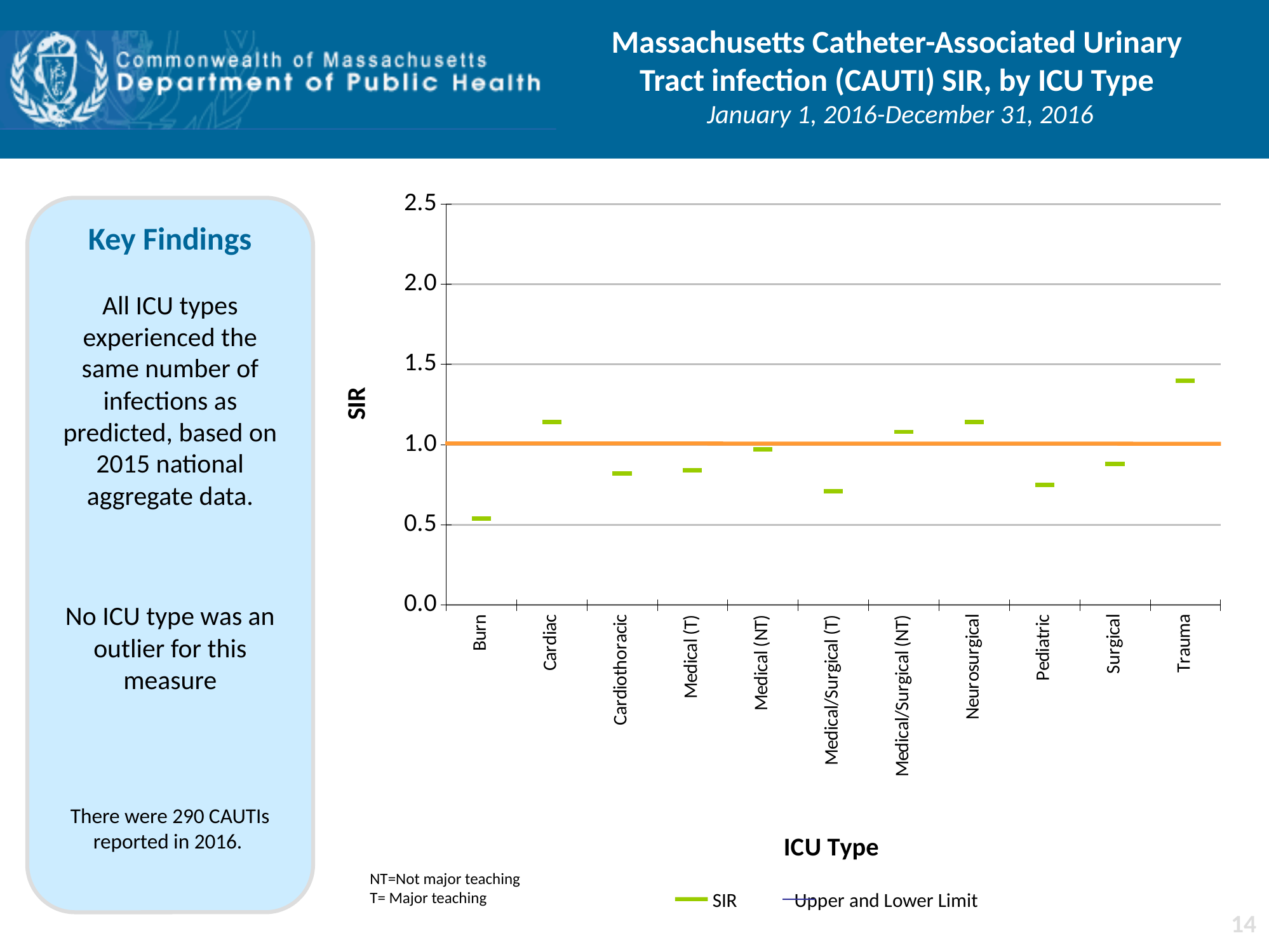
How many ICU types are shown on the x axis of the chart? 11 Which ICU type has the lowest SIR value? Burn Which has a higher SIR value, Cardiac or Cardiothoracic? Cardiac Is the SIR value for Trauma greater or less than 1.0? greater Is the SIR value for Medical/Surgical (T) greater or less than 1.0? less Is the SIR value for Trauma greater or less than 1.5? less Which ICU type has the highest SIR value? Trauma How many series does the chart legend list? 2 What is the title of the chart's x axis? ICU Type Which has a higher SIR value, Medical/Surgical (NT) or Medical/Surgical (T)? Medical/Surgical (NT)